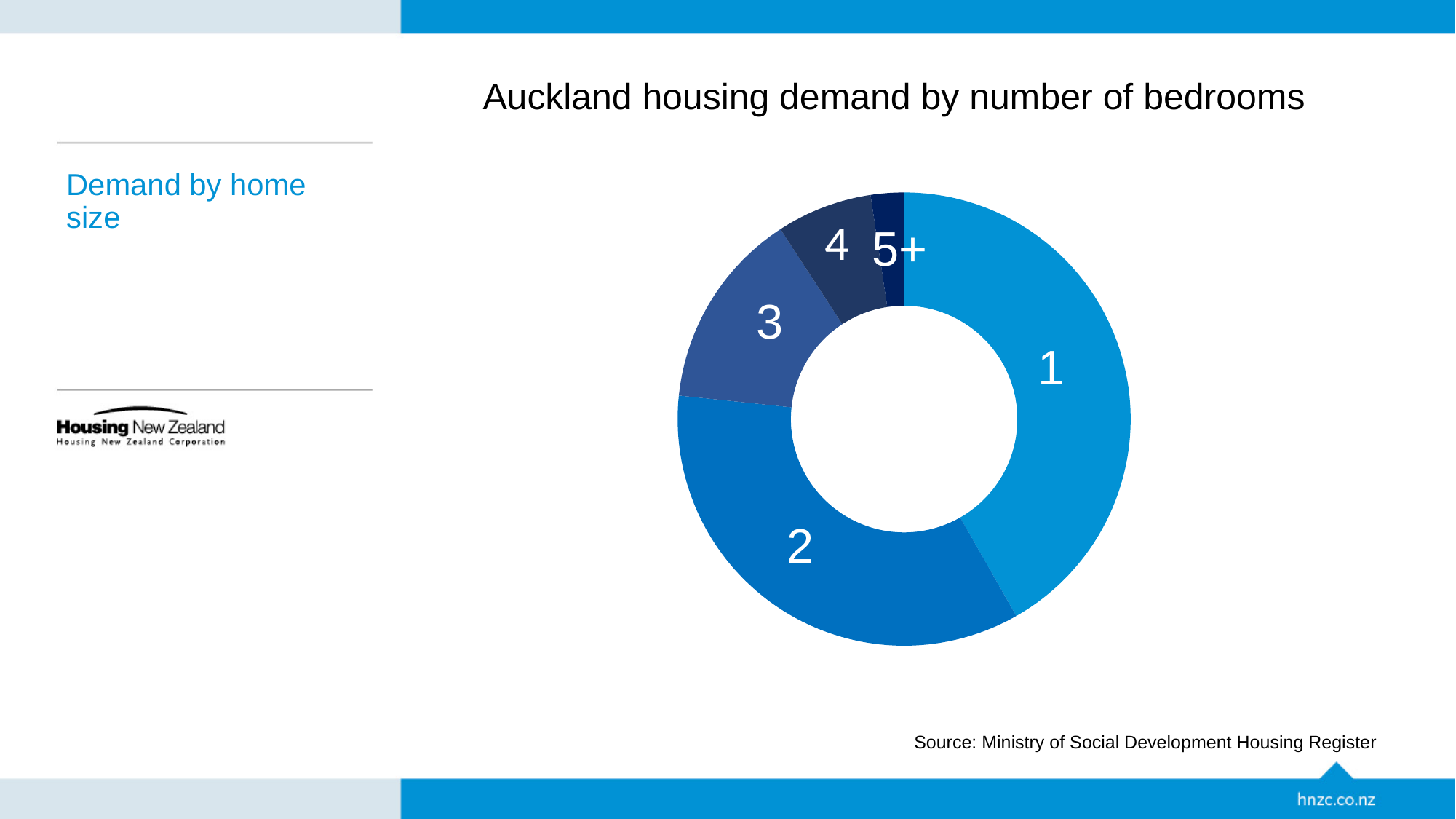
How many categories (slices) does the chart show? 5 What kind of chart is shown on the slide? Doughnut (pie) chart What is the title of the chart? Auckland housing demand by number of bedrooms Which has a larger share of demand: 3-bedroom or 4-bedroom homes? 3 What source is cited for the chart data? Ministry of Social Development Housing Register Which has a larger share of demand: 1-bedroom or 2-bedroom homes? 1 Which has a larger share of demand: 4-bedroom or 5+-bedroom homes? 4 Which bedroom category has the largest share of Auckland housing demand? 1 Which bedroom category has the smallest share of Auckland housing demand? 5+ What is the label of the slice with the darkest colour? 5+